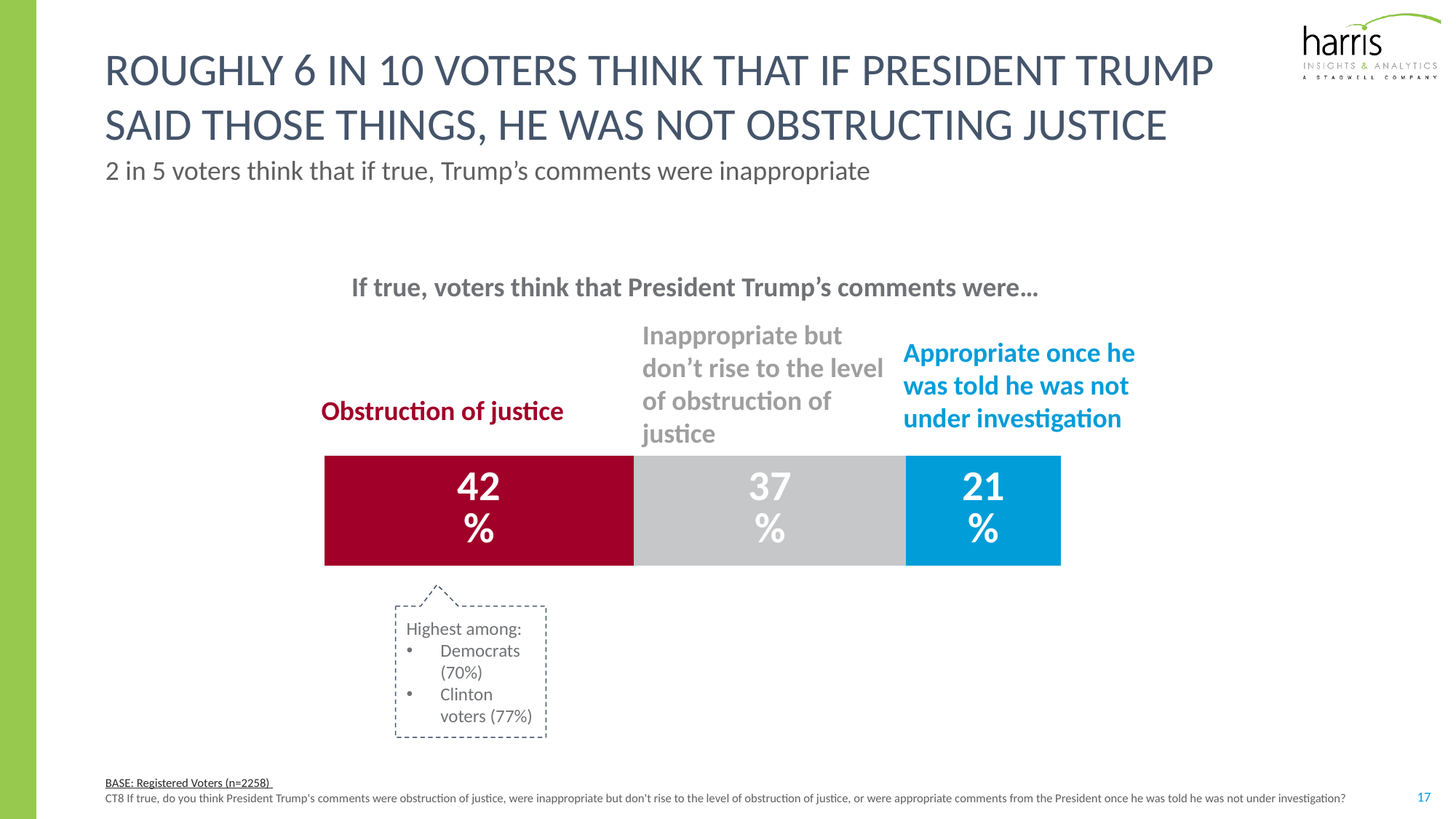
What percentage of voters think President Trump's comments were obstruction of justice? 42% What type of chart is shown on the slide? Stacked bar chart Which response has the lowest share of voters? Appropriate once he was told he was not under investigation What percentage of voters think the comments were inappropriate but don't rise to the level of obstruction of justice? 37% What is the total of the three segments in the stacked bar? 100% What is the difference in percentage points between 'Obstruction of justice' and 'Inappropriate but don't rise to the level of obstruction of justice'? 5 percentage points What is the title of the chart? If true, voters think that President Trump's comments were… How many response categories are shown in the chart? 3 What is the difference in percentage points between 'Obstruction of justice' and 'Appropriate once he was told he was not under investigation'? 21 percentage points Which response has the highest share of voters? Obstruction of justice Which is larger: the share for 'Inappropriate but don't rise to the level of obstruction of justice' or the share for 'Appropriate once he was told he was not under investigation'? Inappropriate but don't rise to the level of obstruction of justice What percentage of voters think the comments were appropriate once he was told he was not under investigation? 21%